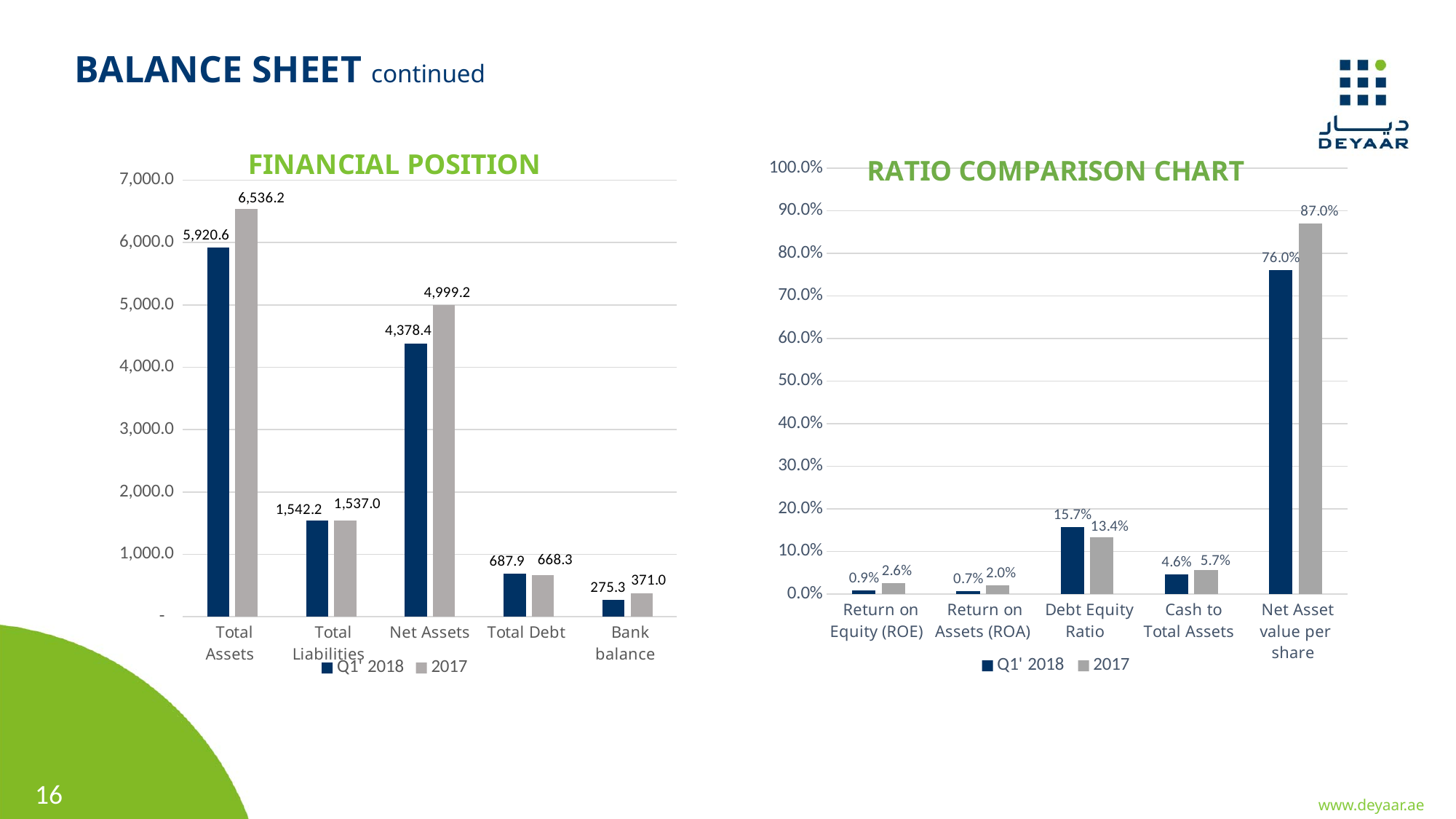
In the FINANCIAL POSITION chart, which category has the lowest Q1' 2018 value? Bank balance In the FINANCIAL POSITION chart, what is the 2017 value for Net Assets? 4,999.2 In the RATIO COMPARISON CHART, which category has the highest Q1' 2018 value? Net Asset value per share In the FINANCIAL POSITION chart, what is the difference between the 2017 and Q1' 2018 values for Total Assets? 615.6 In the FINANCIAL POSITION chart, what is the Q1' 2018 value for Total Assets? 5,920.6 In the FINANCIAL POSITION chart, how many categories are shown on the x axis? 5 What kind of chart is the RATIO COMPARISON CHART? bar chart In the RATIO COMPARISON CHART, what is the Q1' 2018 value for Debt Equity Ratio? 15.7% In the RATIO COMPARISON CHART, what is the 2017 value for Net Asset value per share? 87.0% In the RATIO COMPARISON CHART, what is the difference between the 2017 and Q1' 2018 values for Return on Equity (ROE)? 1.7% In the FINANCIAL POSITION chart, how many series does the legend list? 2 In the FINANCIAL POSITION chart, is the Q1' 2018 value for Total Debt greater or less than the 2017 value? greater